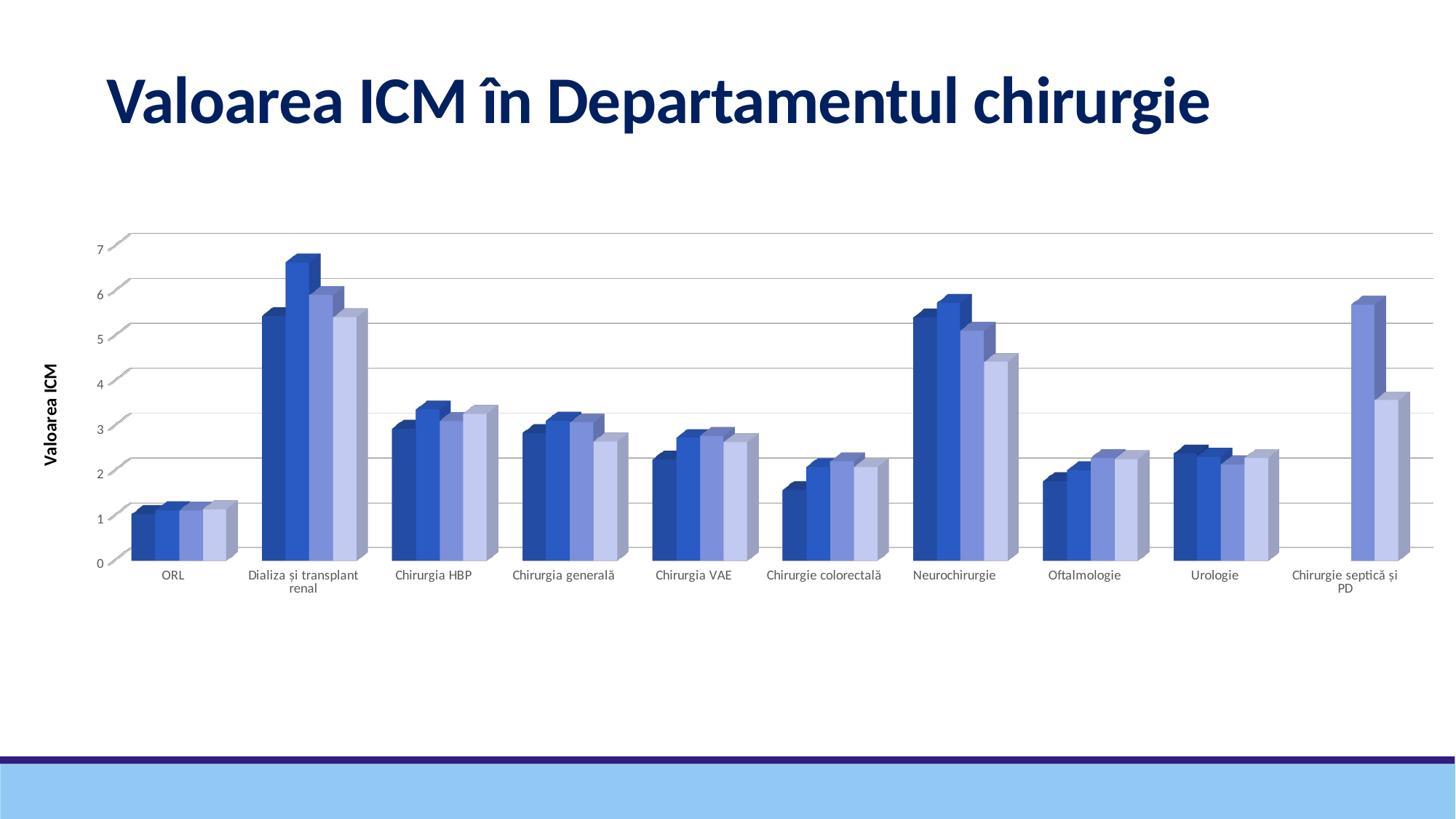
Which category has the tallest bar in the chart? Dializa și transplant renal Is the tallest bar for Dializa și transplant renal greater or less than 6? greater Are the bars for Chirurgie colorectală greater or less than 3? less How many categories are shown on the x axis of the chart? 10 What kind of chart is shown on the slide? bar chart How many bars are shown for the category Chirurgie septică și PD? 2 Are the bars for ORL greater or less than 2? less Which category has higher bars, Neurochirurgie or Oftalmologie? Neurochirurgie Which category has higher bars, Dializa și transplant renal or Chirurgia HBP? Dializa și transplant renal Which category has the lowest bars in the chart? ORL What is the title of the vertical axis of the chart? Valoarea ICM